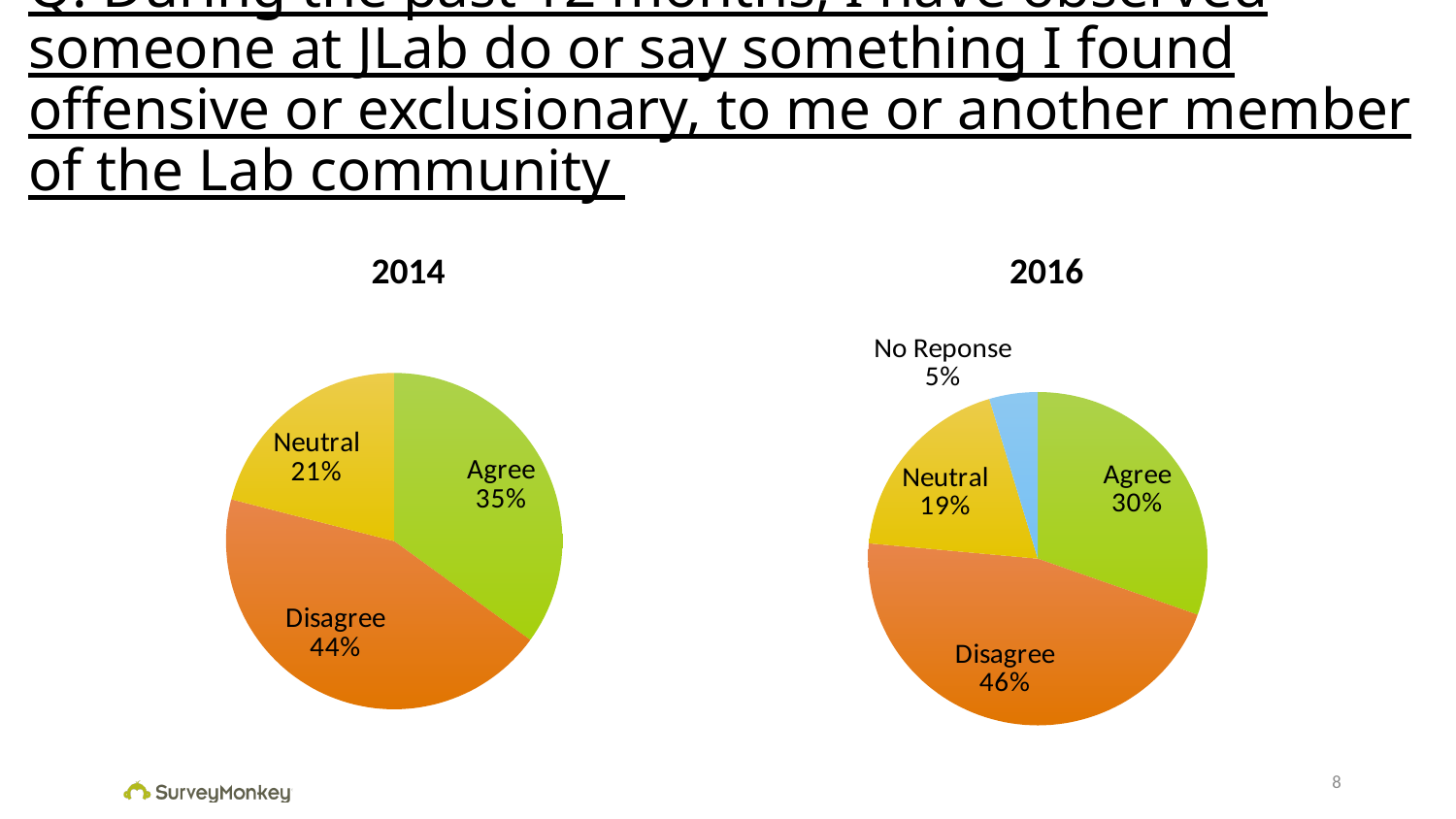
How many slices does the 2016 chart have? 4 In the 2014 chart, what is the difference between the Disagree and Agree percentages? 9% In the 2016 chart, what is the difference between the Agree and Neutral percentages? 11% What type of chart is the 2014 chart? Pie chart In the 2016 chart, what share of the pie is No Reponse? 5% What is the title of the chart on the right side of the slide? 2016 In the 2014 chart, which is larger, Neutral or Agree? Agree In the 2016 chart, which response has the smallest slice? No Reponse In the 2014 chart, which response has the largest slice? Disagree How many slices does the 2014 chart have? 3 In the 2016 chart, what percentage of respondents chose Agree? 30% In the 2014 chart, what percentage of respondents chose Disagree? 44%